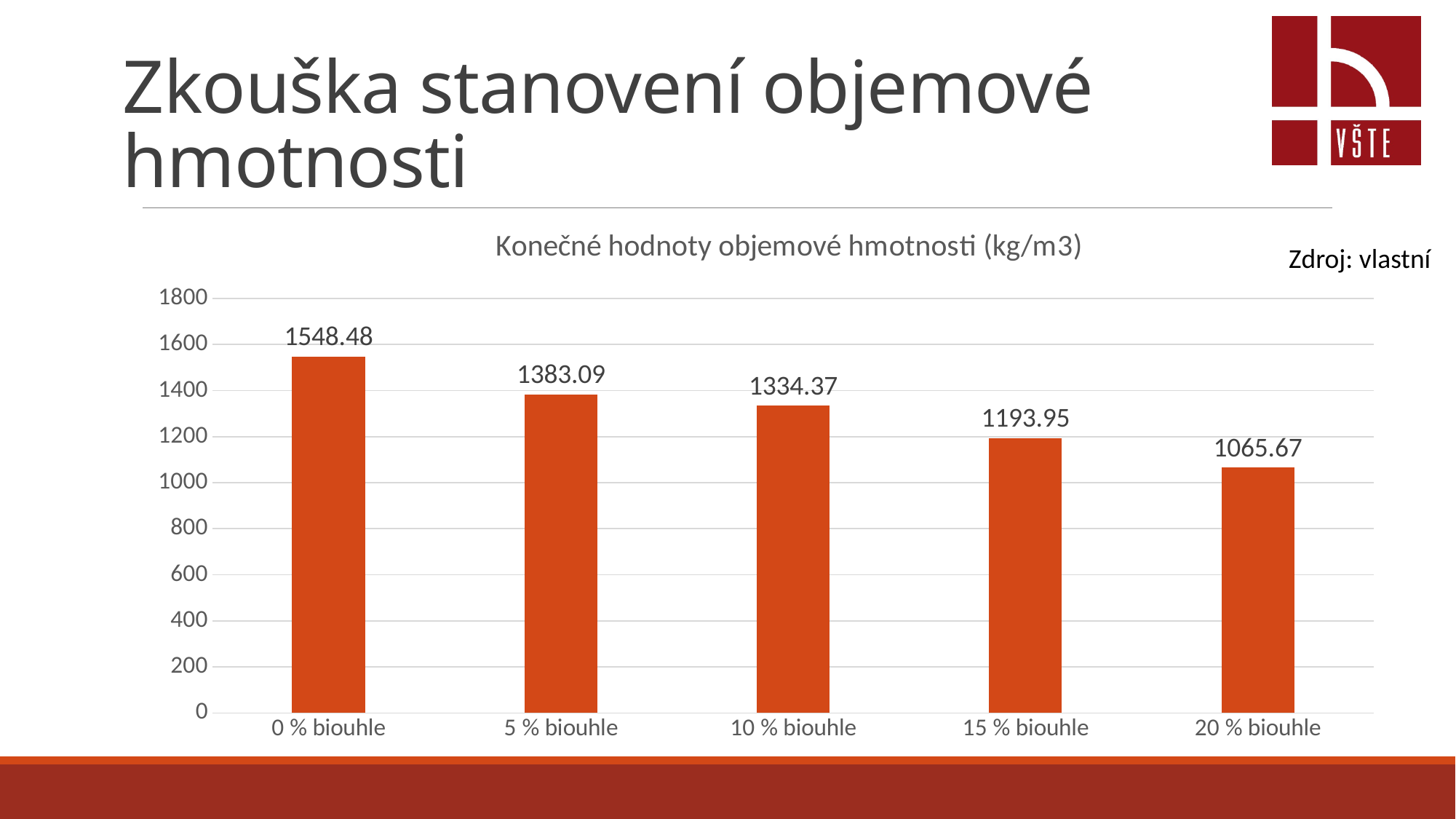
Which category has the lowest value? 20 % biouhle Is the value for 15 % biouhle greater or less than 1200? less Which is larger, the value for 5 % biouhle or the value for 15 % biouhle? 5 % biouhle What is the value for 20 % biouhle? 1065.67 What is the value for 0 % biouhle? 1548.48 Which category has the highest value? 0 % biouhle How many categories are shown on the x axis? 5 What kind of chart is shown on the slide? bar chart What is the difference between the values for 15 % biouhle and 20 % biouhle? 128.28 What is the value for 10 % biouhle? 1334.37 What is the difference between the values for 0 % biouhle and 5 % biouhle? 165.39 Do the values rise or fall as the share of biouhle increases along the x axis? fall